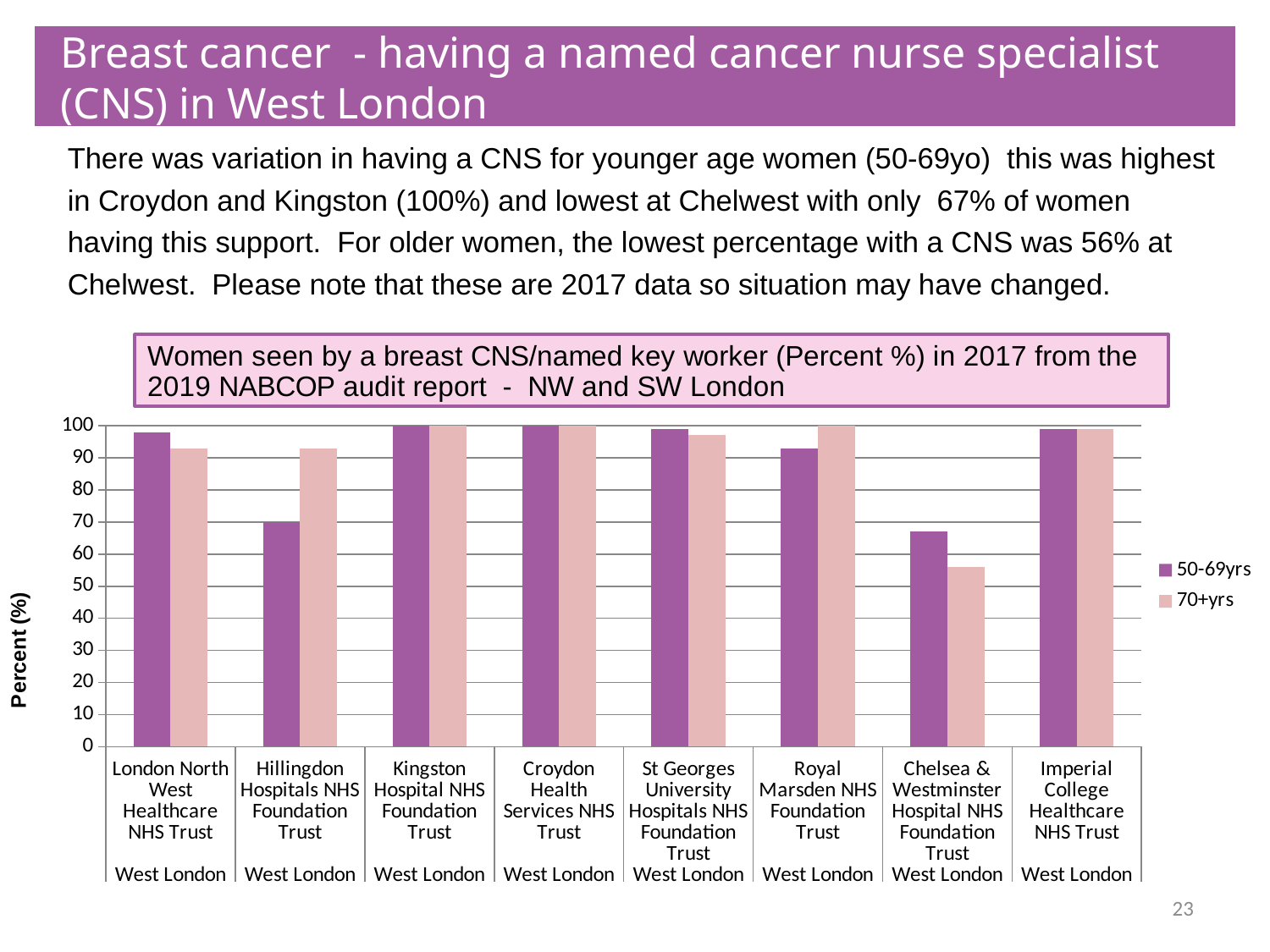
What is the value for the 50-69yrs series at Kingston Hospital NHS Foundation Trust? 100 What is the value for the 70+yrs series at Croydon Health Services NHS Trust? 100 Which trust has the lowest value for the 70+yrs series? Chelsea & Westminster Hospital NHS Foundation Trust Is the value for the 70+yrs series at London North West Healthcare NHS Trust greater or less than 90? greater What kind of chart is shown on the slide? bar chart Is the value for the 70+yrs series at Chelsea & Westminster Hospital NHS Foundation Trust greater or less than 60? less What is the label on the y axis? Percent (%) How many series does the legend list? 2 How many trusts are shown along the x axis? 8 Which trust has the lowest value for the 50-69yrs series? Chelsea & Westminster Hospital NHS Foundation Trust At Royal Marsden NHS Foundation Trust, which series has the larger value, 50-69yrs or 70+yrs? 70+yrs What is the value for the 50-69yrs series at Hillingdon Hospitals NHS Foundation Trust? 70